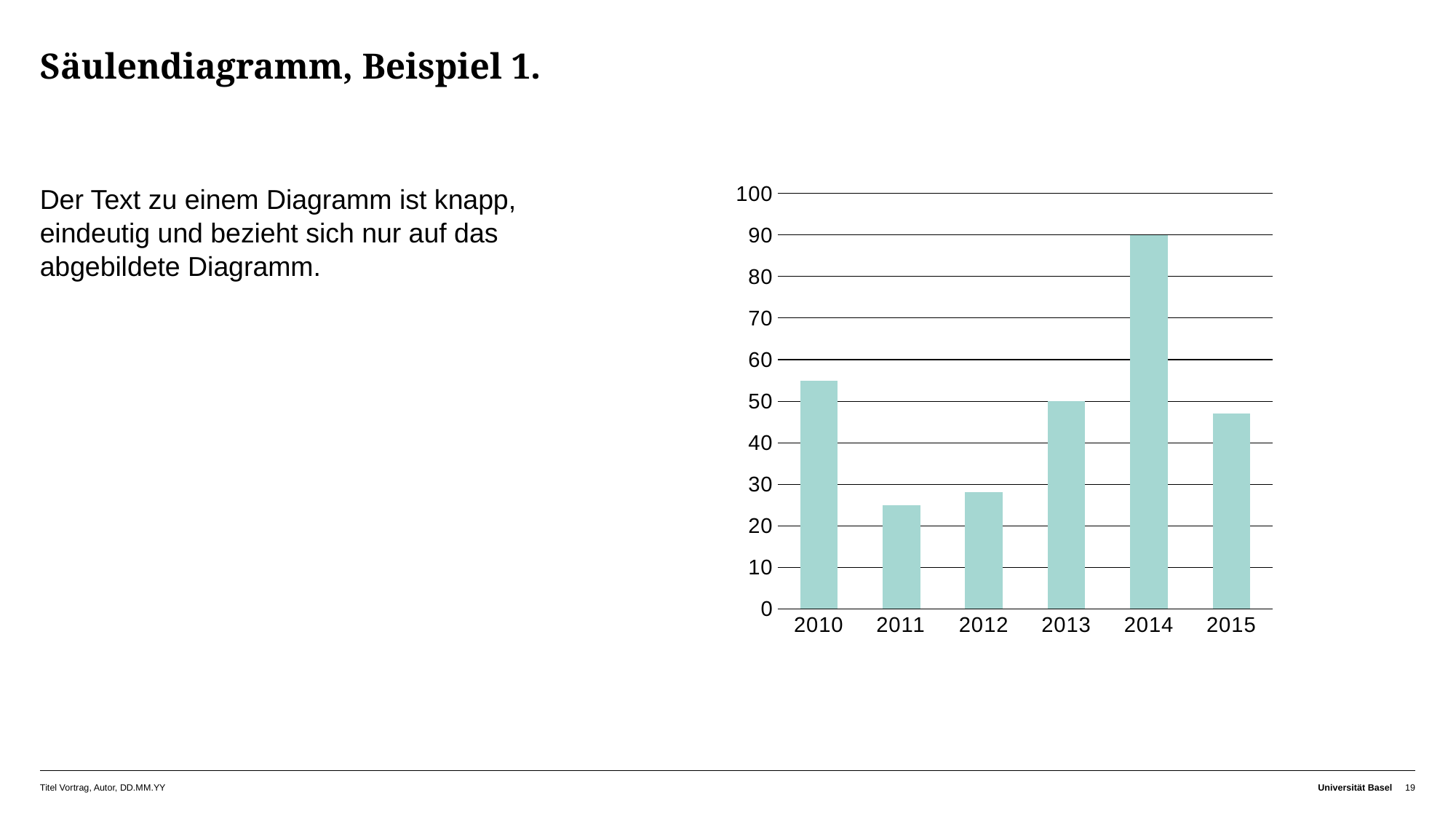
Is the value for 2010 greater or less than 50? greater Is the value for 2011 greater or less than 30? less Is the value for 2015 greater or less than 40? greater What is the value for 2013 in the chart? 50 Which year has the highest bar in the chart? 2014 What is the value for 2014 in the chart? 90 What kind of chart is shown on the slide? bar chart Which year has the lowest bar in the chart? 2011 What is the difference between the values for 2014 and 2013? 40 What is the highest value shown on the y axis of the chart? 100 How many years are shown on the x axis of the chart? 6 Which is larger, the value for 2010 or the value for 2013? 2010